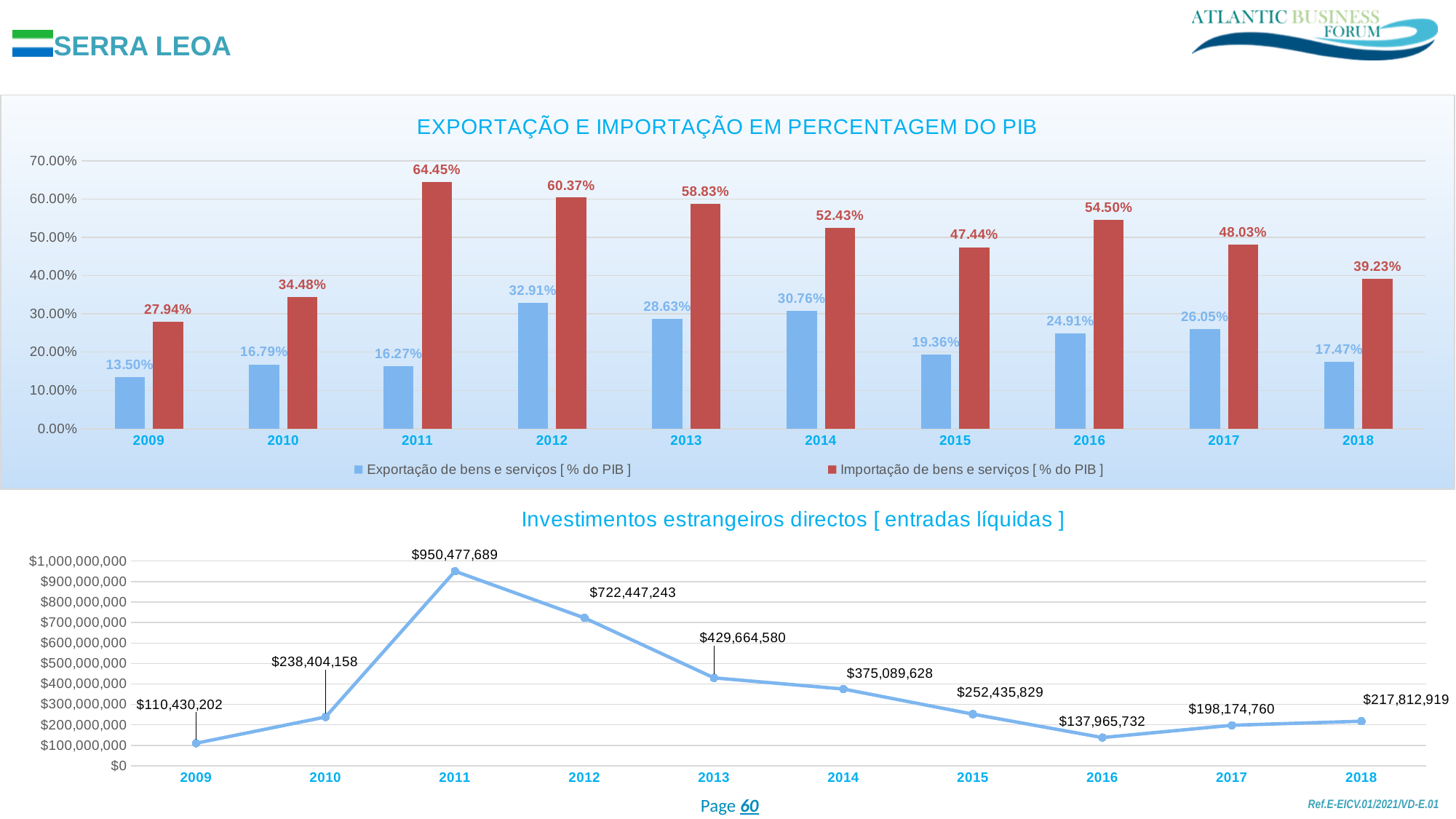
In the 'EXPORTAÇÃO E IMPORTAÇÃO EM PERCENTAGEM DO PIB' chart, which year has the highest Exportação de bens e serviços value? 2012 In the 'EXPORTAÇÃO E IMPORTAÇÃO EM PERCENTAGEM DO PIB' chart, how many series does the legend list? 2 In the 'Investimentos estrangeiros directos [ entradas líquidas ]' chart, is the value for 2016 larger or smaller than the value for 2017? Smaller What kind of chart is the 'EXPORTAÇÃO E IMPORTAÇÃO EM PERCENTAGEM DO PIB' chart? Bar chart In the 'EXPORTAÇÃO E IMPORTAÇÃO EM PERCENTAGEM DO PIB' chart, what is the value of Exportação de bens e serviços in 2014? 30.76% In the 'EXPORTAÇÃO E IMPORTAÇÃO EM PERCENTAGEM DO PIB' chart, what is the difference between Importação and Exportação in 2018? 21.76% In the 'EXPORTAÇÃO E IMPORTAÇÃO EM PERCENTAGEM DO PIB' chart, which year has the lowest Importação de bens e serviços value? 2009 In the 'Investimentos estrangeiros directos [ entradas líquidas ]' chart, what is the value for 2011? $950,477,689 In the 'EXPORTAÇÃO E IMPORTAÇÃO EM PERCENTAGEM DO PIB' chart, what is the value of Importação de bens e serviços in 2011? 64.45% In the 'Investimentos estrangeiros directos [ entradas líquidas ]' chart, how many years are plotted? 10 In the 'Investimentos estrangeiros directos [ entradas líquidas ]' chart, which year has the lowest value? 2009 What kind of chart is the 'Investimentos estrangeiros directos [ entradas líquidas ]' chart? Line chart